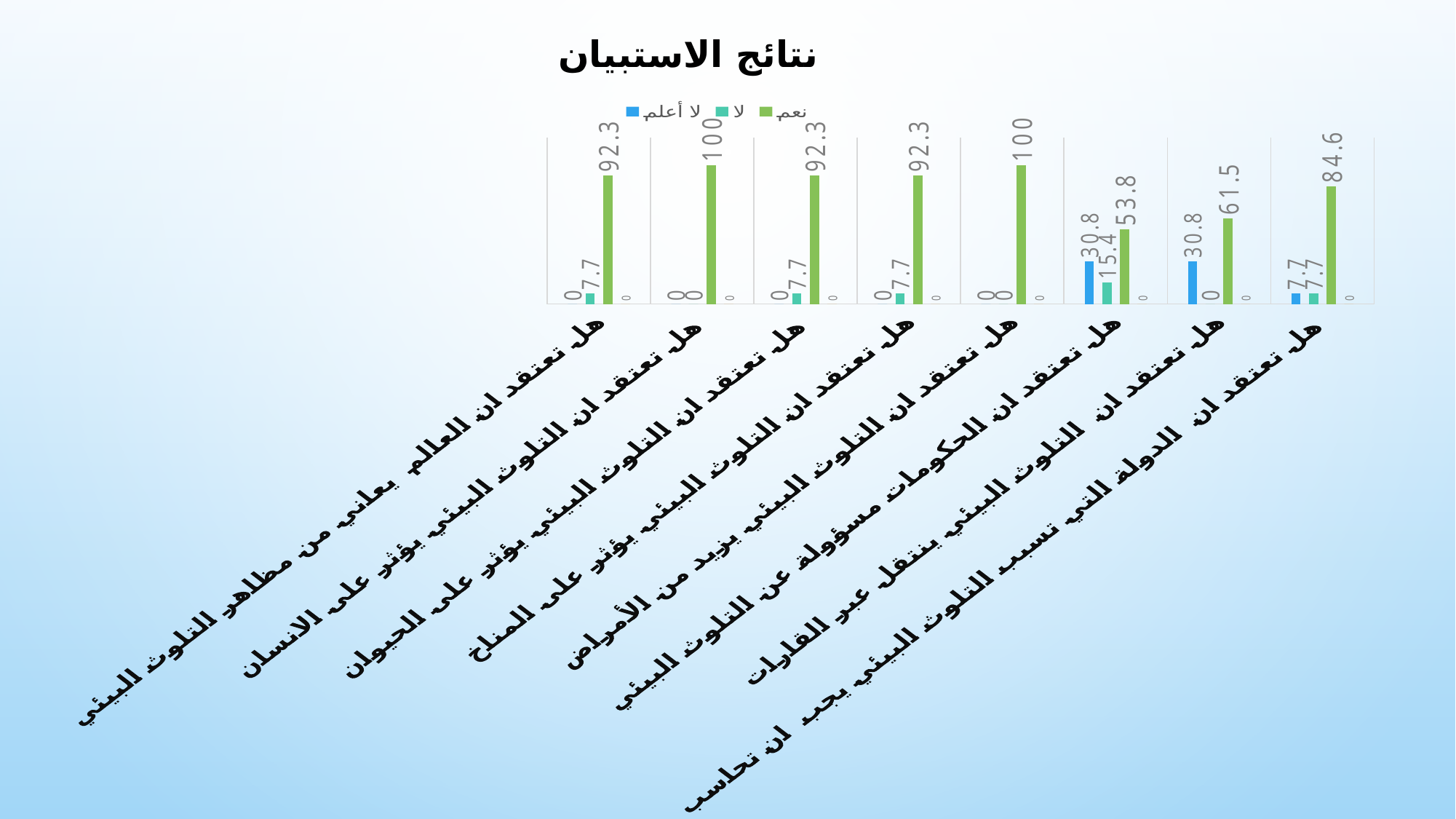
What colour are the نعم bars? green What is the value of لا أعلم for the question هل تعتقد ان التلوث البيئي ينتقل عبر القارات? 30.8 What is the difference between the نعم values for هل تعتقد ان التلوث البيئي يؤثر على الانسان and هل تعتقد ان التلوث البيئي ينتقل عبر القارات? 38.5 How many question categories are shown on the x axis? 8 What type of chart is shown on the slide? bar chart How many series does the legend list? 3 Which question has the lowest نعم value? هل تعتقد ان الحكومات مسؤولة عن التلوث البيئي What is the value of لا for the question هل تعتقد ان الحكومات مسؤولة عن التلوث البيئي? 15.4 What is the value of نعم for the question هل تعتقد ان الدولة التي تسبب التلوث البيئي يجب ان تحاسب? 84.6 What is the title of the chart? نتائج الاستبيان What is the value of نعم for the question هل تعتقد ان الحكومات مسؤولة عن التلوث البيئي? 53.8 Which is larger for the question هل تعتقد ان الحكومات مسؤولة عن التلوث البيئي: the لا أعلم value or the لا value? لا أعلم